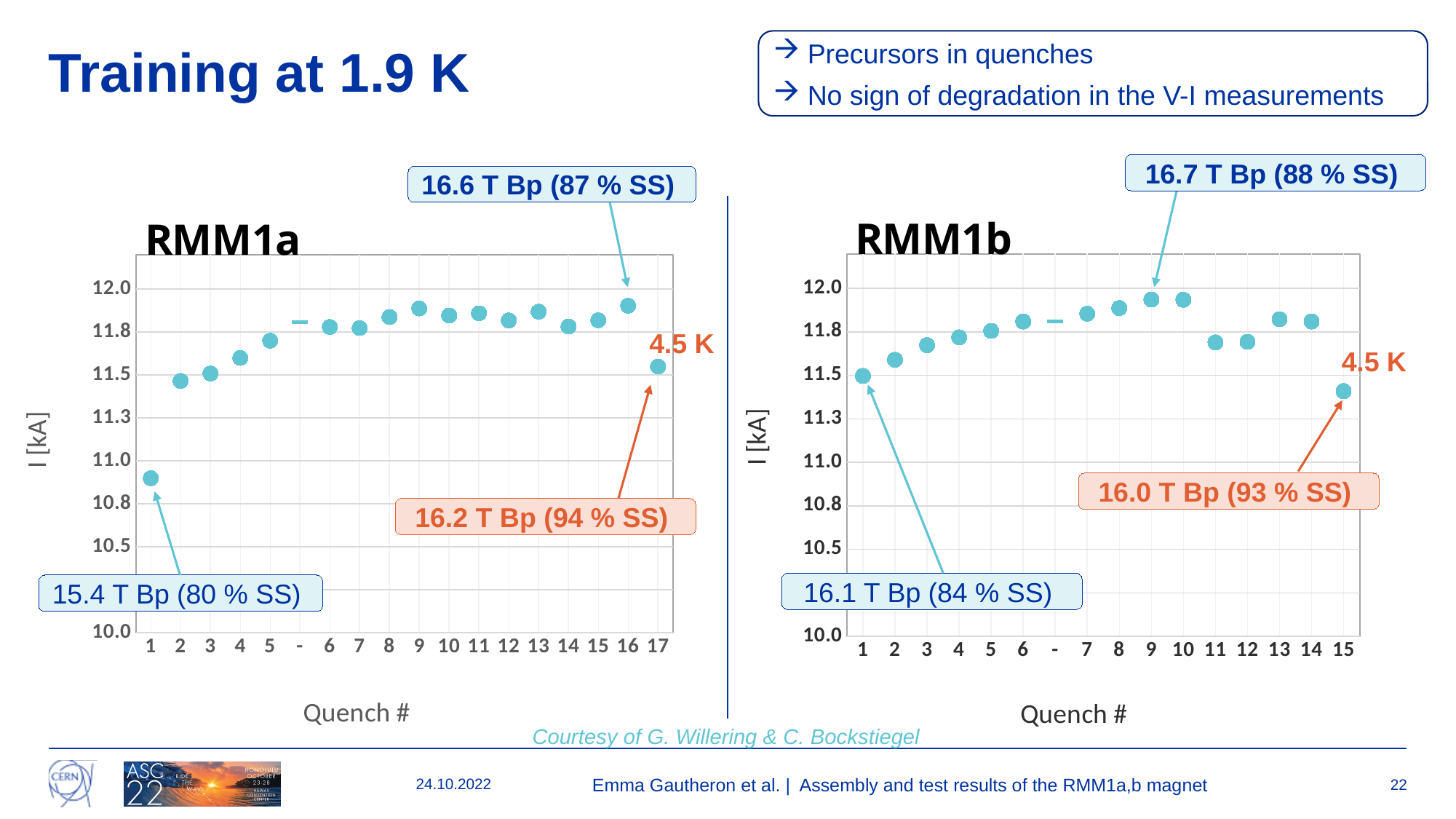
How many quench points are plotted on the RMM1a chart? 17 On the RMM1b chart, is the value for quench 15 greater or less than 11.5? less On the RMM1a chart, is the value for quench 9 greater or less than 11.8? greater On the RMM1b chart, is the value for quench 11 greater or less than 11.8? less On the RMM1a chart, which has the larger current, quench 1 or quench 17? quench 17 On the RMM1a chart, which quench number has the lowest current? 1 How many quench points are plotted on the RMM1b chart? 15 What is the y-axis label on the RMM1b chart? I [kA] What kind of chart is the RMM1a chart? scatter chart On the RMM1a chart, do the values rise or fall from quench 1 to quench 5? rise On the RMM1b chart, which has the larger current, quench 1 or quench 9? quench 9